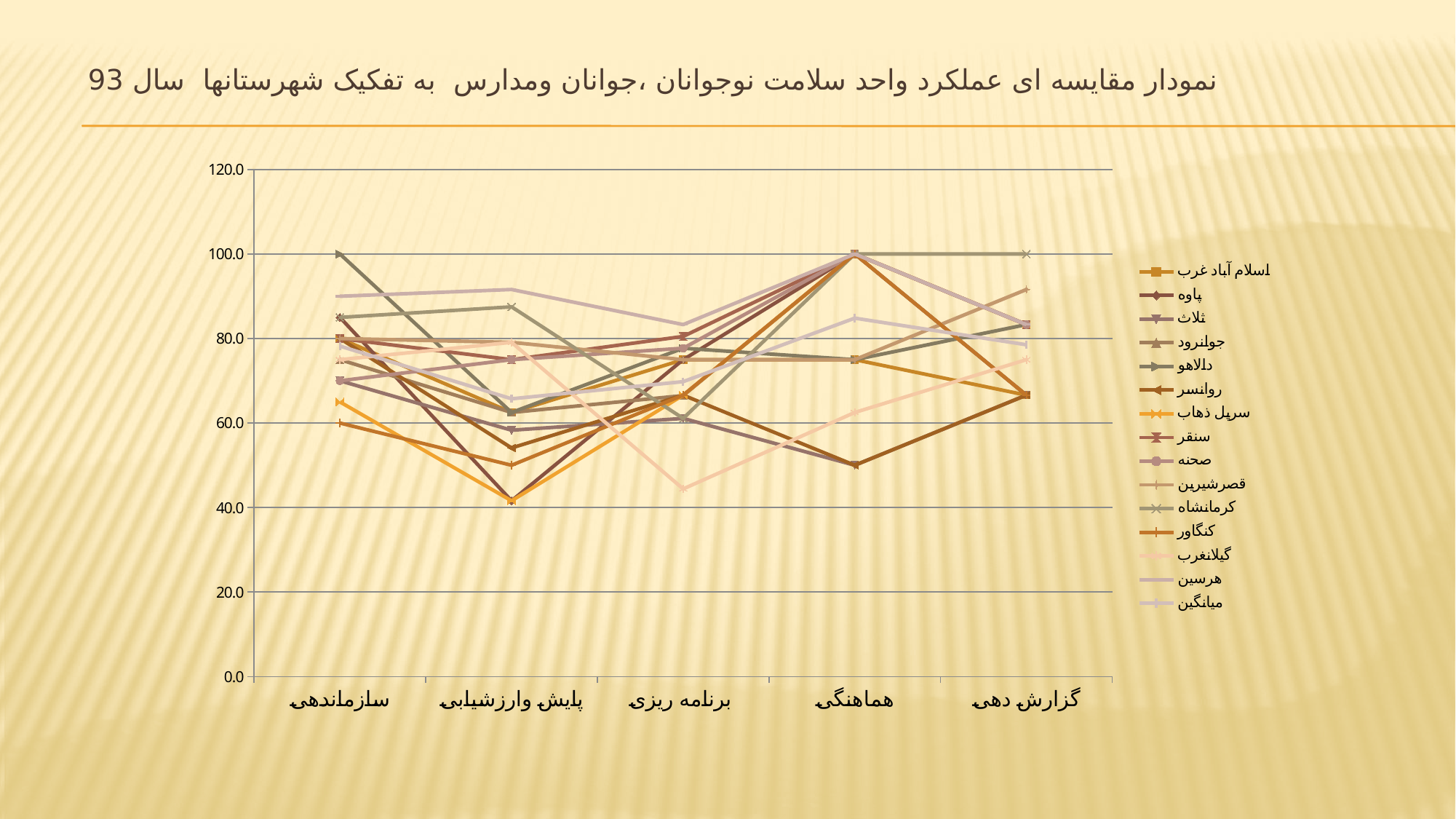
What is the highest value shown on the chart's y axis? 120.0 What is the value for کرمانشاه at گزارش دهی? 100.0 How many series does the chart's legend list? 15 Is the value for دالاهو at سازماندهی greater or less than 80? greater What kind of chart is shown on the slide? line chart What is the title of the chart on the slide? نمودار مقایسه ای عملکرد واحد سلامت نوجوانان ،جوانان ومدارس به تفکیک شهرستانها سال 93 Is the value for کرمانشاه at گزارش دهی greater or less than 80? greater Is the value for گیلانغرب at برنامه ریزی greater or less than 60? less How many categories are shown along the x axis of the chart? 5